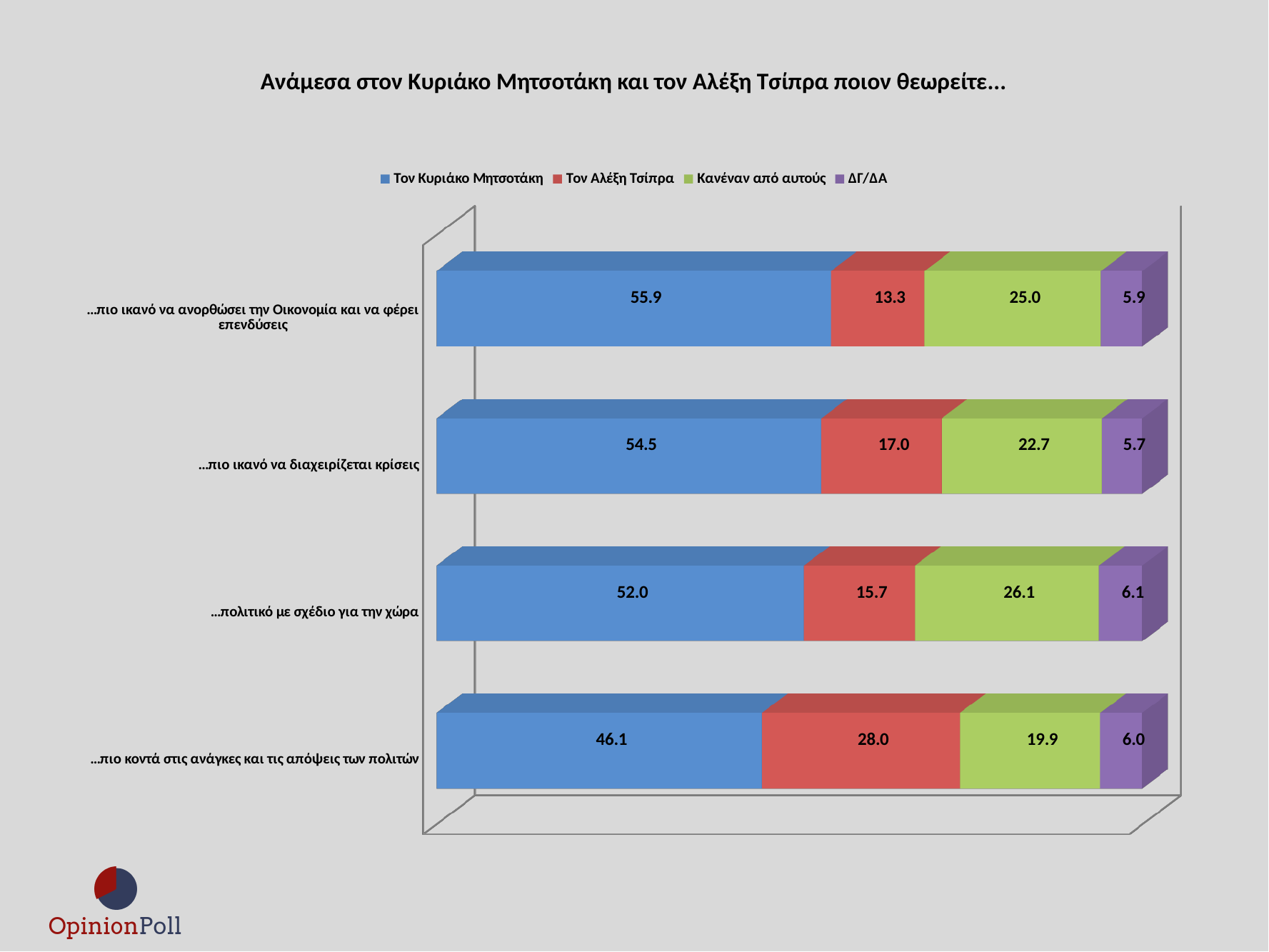
In which category does Τον Αλέξη Τσίπρα have the highest value? ...πιο κοντά στις ανάγκες και τις απόψεις των πολιτών What is the value for ΔΓ/ΔΑ in the category '...πιο ικανό να διαχειρίζεται κρίσεις'? 5.7 What is the difference between the Τον Κυριάκο Μητσοτάκη and Τον Αλέξη Τσίπρα values in the category '...πιο ικανό να διαχειρίζεται κρίσεις'? 37.5 What type of chart is shown on the slide? Stacked bar chart Which is larger in the category '...πολιτικό με σχέδιο για την χώρα': the value for Τον Αλέξη Τσίπρα or the value for Κανέναν από αυτούς? Κανέναν από αυτούς What is the value for Κανέναν από αυτούς in the category '...πολιτικό με σχέδιο για την χώρα'? 26.1 In which category does Τον Κυριάκο Μητσοτάκη have the lowest value? ...πιο κοντά στις ανάγκες και τις απόψεις των πολιτών How many series does the legend list? 4 What is the value for Τον Κυριάκο Μητσοτάκη in the category '...πιο ικανό να ανορθώσει την Οικονομία και να φέρει επενδύσεις'? 55.9 What is the total of the stacked bar for '...πιο κοντά στις ανάγκες και τις απόψεις των πολιτών'? 100.0 What is the value for Τον Αλέξη Τσίπρα in the category '...πιο κοντά στις ανάγκες και τις απόψεις των πολιτών'? 28.0 How many categories (questions) are plotted on the chart? 4